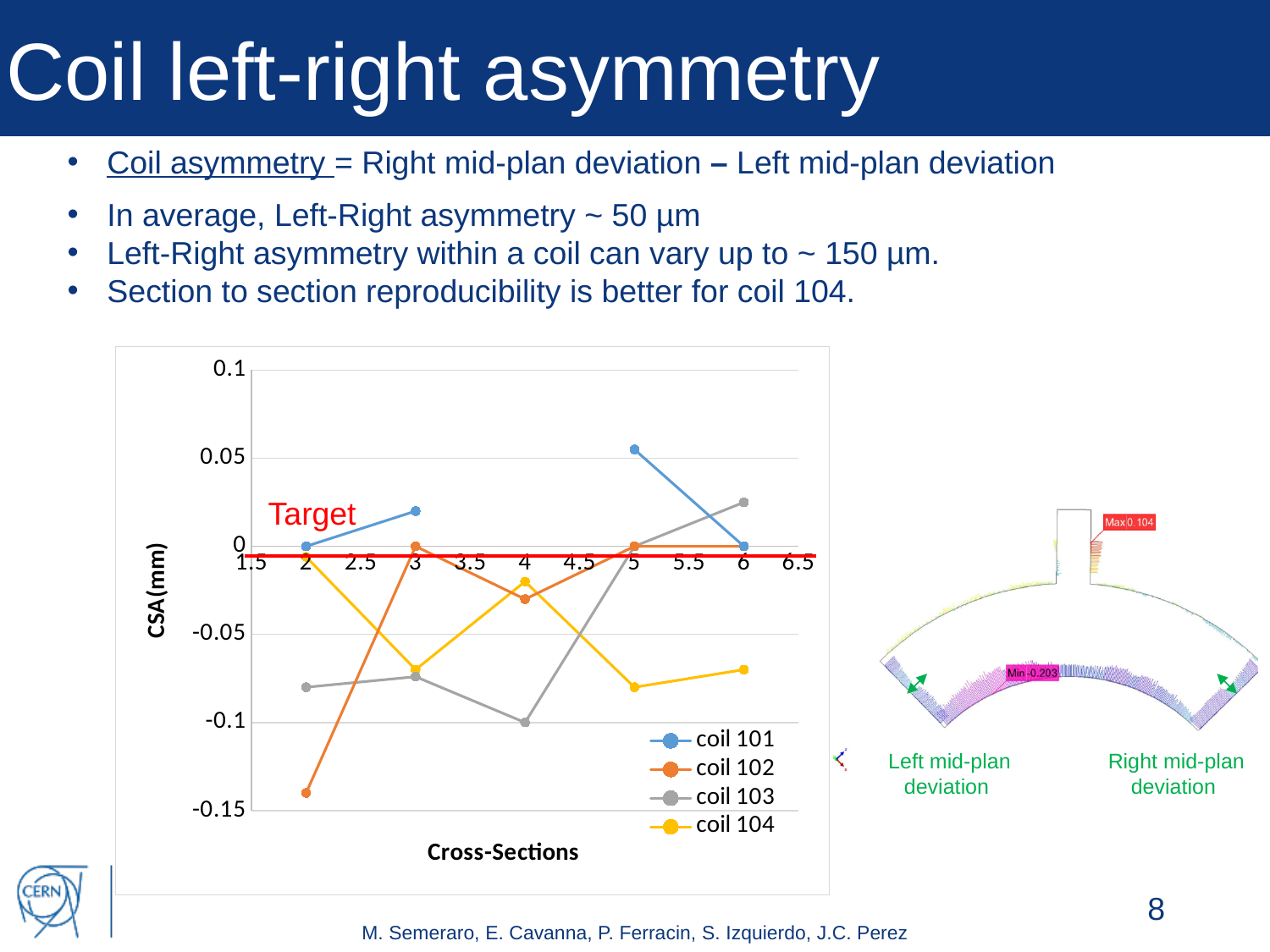
Which series contains the lowest value plotted on the chart? coil 102 Is the value for coil 103 at cross-section 6 greater or less than 0? greater How many series does the chart legend list? 4 Does the value for coil 101 rise or fall from cross-section 5 to cross-section 6? fall At cross-section 4, which series has the higher value, coil 103 or coil 104? coil 104 What is the title of the vertical axis of the chart? CSA(mm) What is the title of the horizontal axis of the chart? Cross-Sections Is the value for coil 102 at cross-section 2 greater or less than -0.1? less Is the value for coil 104 at cross-section 5 greater or less than -0.05? less At cross-section 2, which series has the higher value, coil 102 or coil 103? coil 103 What kind of chart is shown on the slide? line chart